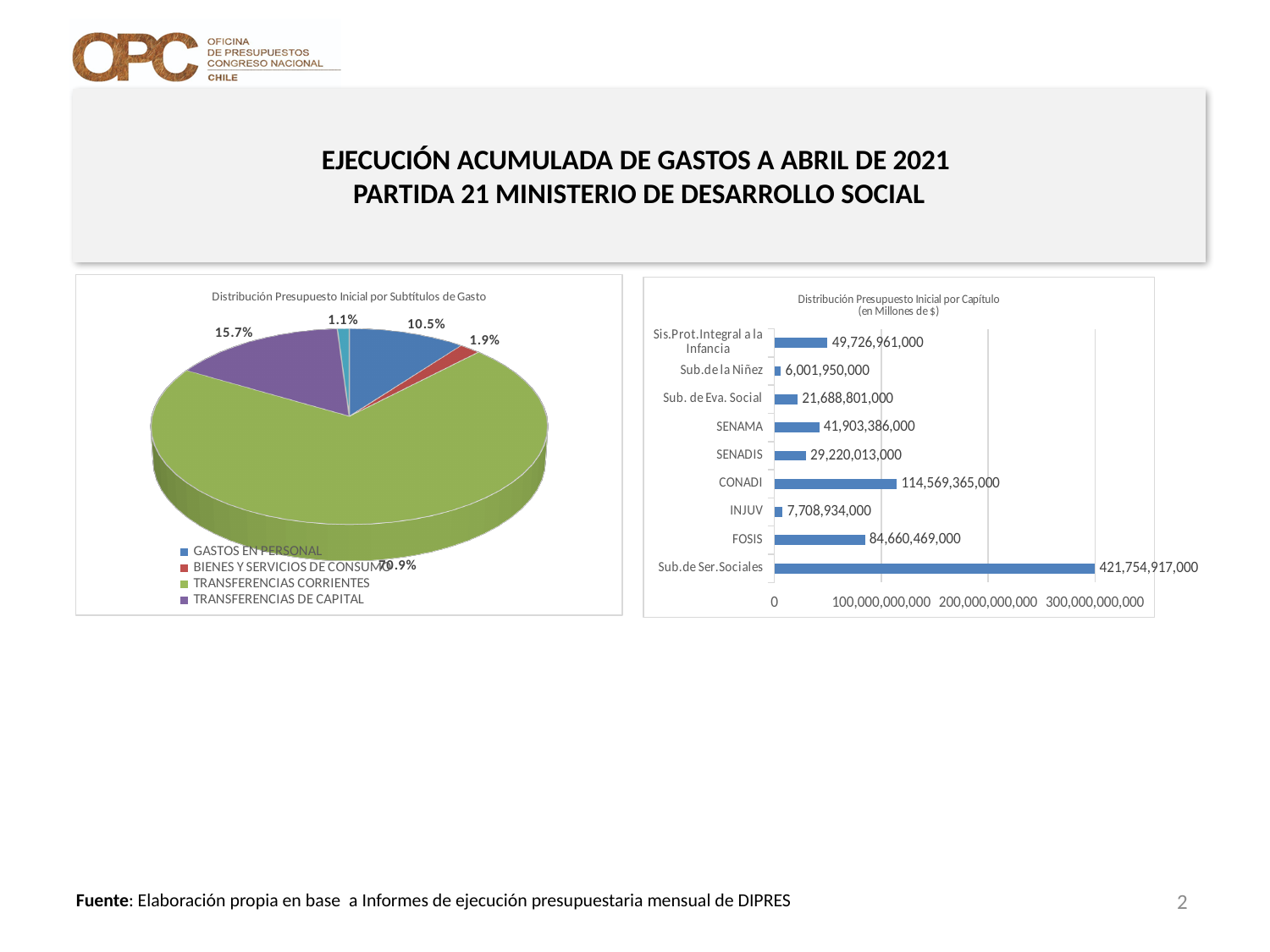
In the bar chart 'Distribución Presupuesto Inicial por Capítulo', which category has the lowest value? Sub.de la Niñez In the bar chart 'Distribución Presupuesto Inicial por Capítulo', what is the value for CONADI? 114,569,365,000 What kind of chart is the chart on the right of the slide? Bar chart In the pie chart 'Distribución Presupuesto Inicial por Subtítulos de Gasto', what share does TRANSFERENCIAS DE CAPITAL have? 15.7% In the bar chart 'Distribución Presupuesto Inicial por Capítulo', how many categories are shown? 9 In the bar chart 'Distribución Presupuesto Inicial por Capítulo', what is the difference between the values for CONADI and FOSIS? 29,908,896,000 In the bar chart 'Distribución Presupuesto Inicial por Capítulo', which category has the highest value? Sub.de Ser.Sociales In the pie chart 'Distribución Presupuesto Inicial por Subtítulos de Gasto', what share does TRANSFERENCIAS CORRIENTES have? 70.9% In the bar chart 'Distribución Presupuesto Inicial por Capítulo', which is larger, SENADIS or SENAMA? SENAMA In the bar chart 'Distribución Presupuesto Inicial por Capítulo', what is the value for SENAMA? 41,903,386,000 What kind of chart is the chart on the left of the slide? Pie chart In the bar chart 'Distribución Presupuesto Inicial por Capítulo', what is the value for FOSIS? 84,660,469,000